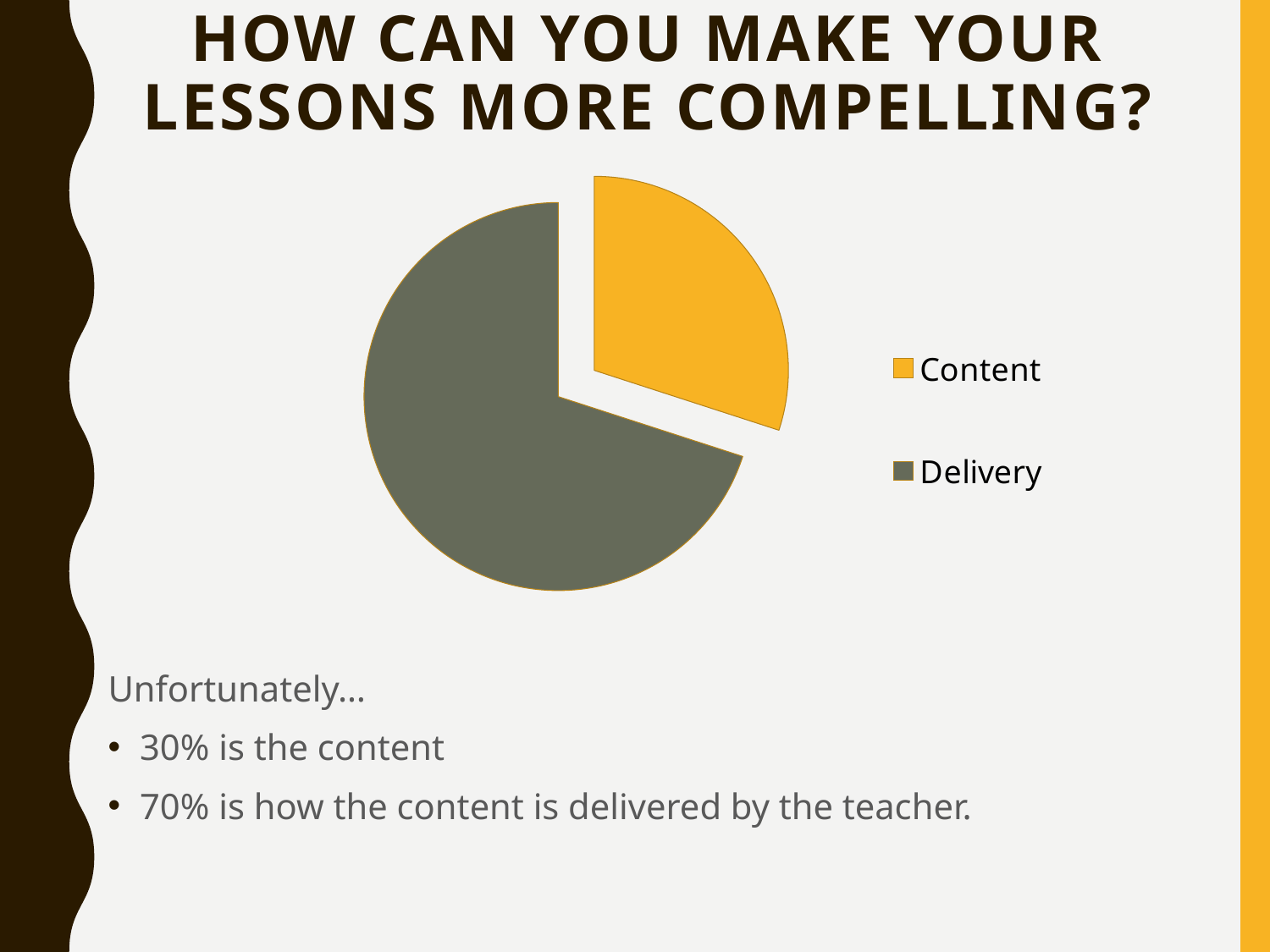
Which slice of the pie chart is the smallest? Content How many entries does the legend of the pie chart list? 2 What is the difference in percentage points between the Delivery and Content slices? 40 What share of the pie does the Delivery slice represent? 70% Which legend entry is shown in grey? Delivery How many slices does the pie chart have? 2 Which slice of the pie chart is the largest? Delivery Which is larger in the pie chart, Content or Delivery? Delivery What share of the pie does the Content slice represent? 30% What colour is the Content slice in the pie chart? yellow What kind of chart is shown on the slide? pie chart